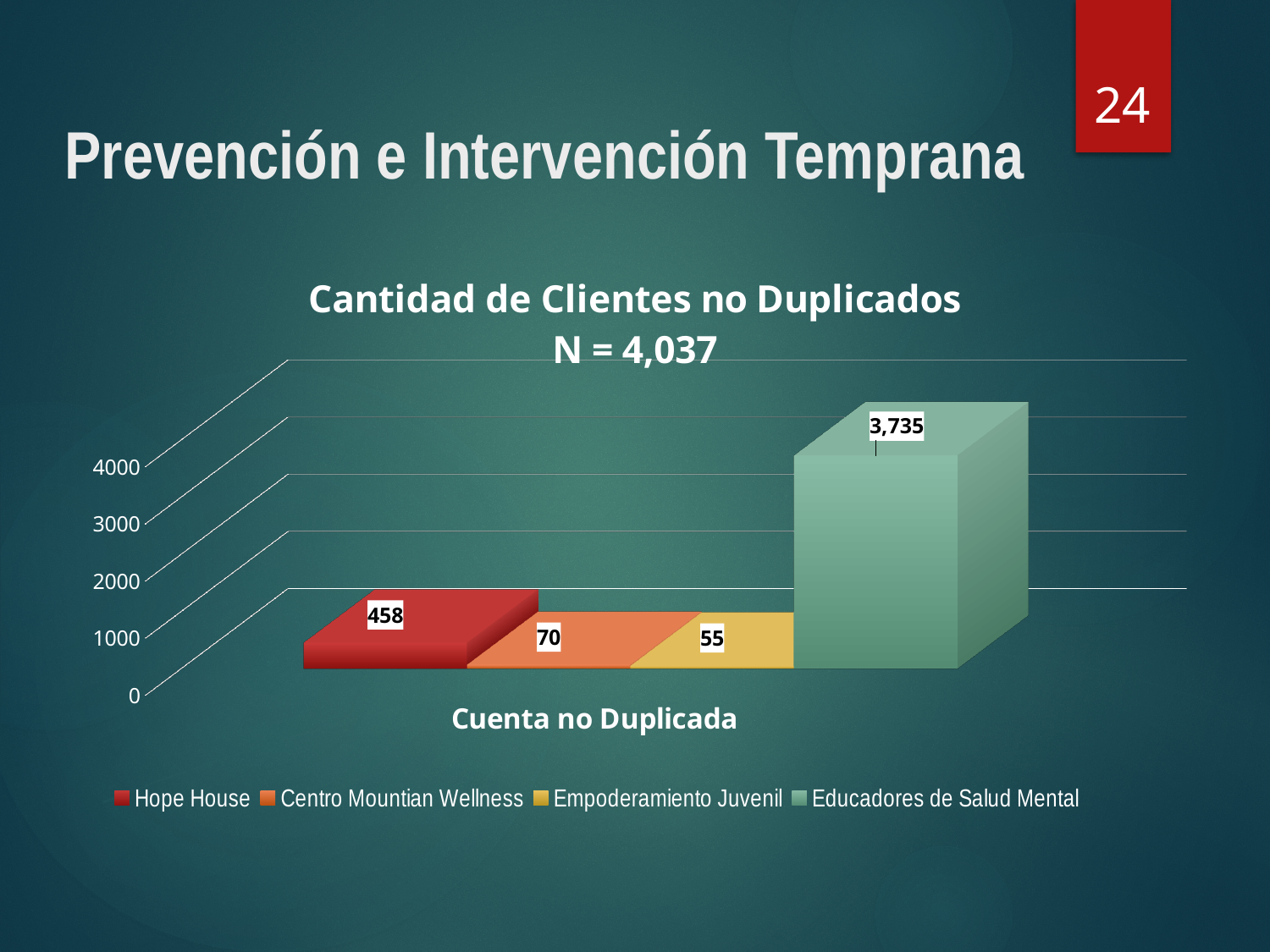
What is the value for Educadores de Salud Mental? 3,735 Which series has the lowest value? Empoderamiento Juvenil What is the title of the chart? Cantidad de Clientes no Duplicados N = 4,037 What is the difference between the values for Educadores de Salud Mental and Hope House? 3,277 What is the value for Centro Mountian Wellness? 70 Which is larger, the value for Hope House or the value for Centro Mountian Wellness? Hope House What is the difference between the values for Centro Mountian Wellness and Empoderamiento Juvenil? 15 How many series does the legend list? 4 What kind of chart is shown on the slide? Bar chart What is the value for Empoderamiento Juvenil? 55 Which series has the highest value? Educadores de Salud Mental What is the value for Hope House? 458